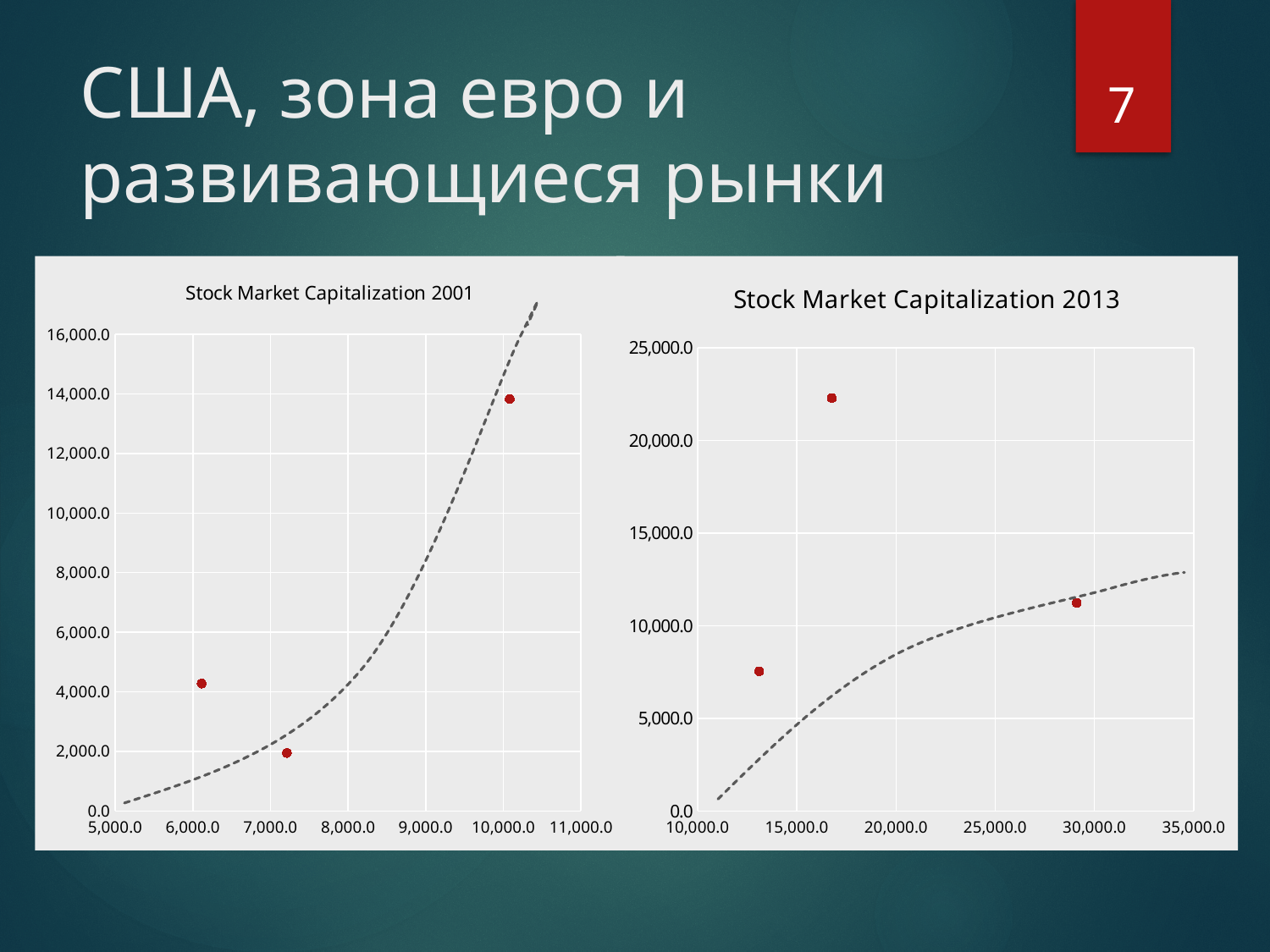
In the 'Stock Market Capitalization 2001' chart, is the vertical value of the highest point greater or less than 12,000.0? greater How many data points are plotted in the 'Stock Market Capitalization 2013' chart? 3 What is the title of the chart on the left side of the slide? Stock Market Capitalization 2001 In the 'Stock Market Capitalization 2001' chart, does the dashed trend line rise or fall from left to right? rises What is the highest tick value shown on the vertical axis of the 'Stock Market Capitalization 2013' chart? 25,000.0 In the 'Stock Market Capitalization 2001' chart, is the rightmost point higher or lower on the vertical axis than the leftmost point? higher What kind of chart is the 'Stock Market Capitalization 2001' chart? scatter chart In the 'Stock Market Capitalization 2001' chart, is the vertical value of the lowest point greater or less than 4,000.0? less In the 'Stock Market Capitalization 2013' chart, is the horizontal value of the rightmost point greater or less than 25,000.0? greater How many data points are plotted in the 'Stock Market Capitalization 2001' chart? 3